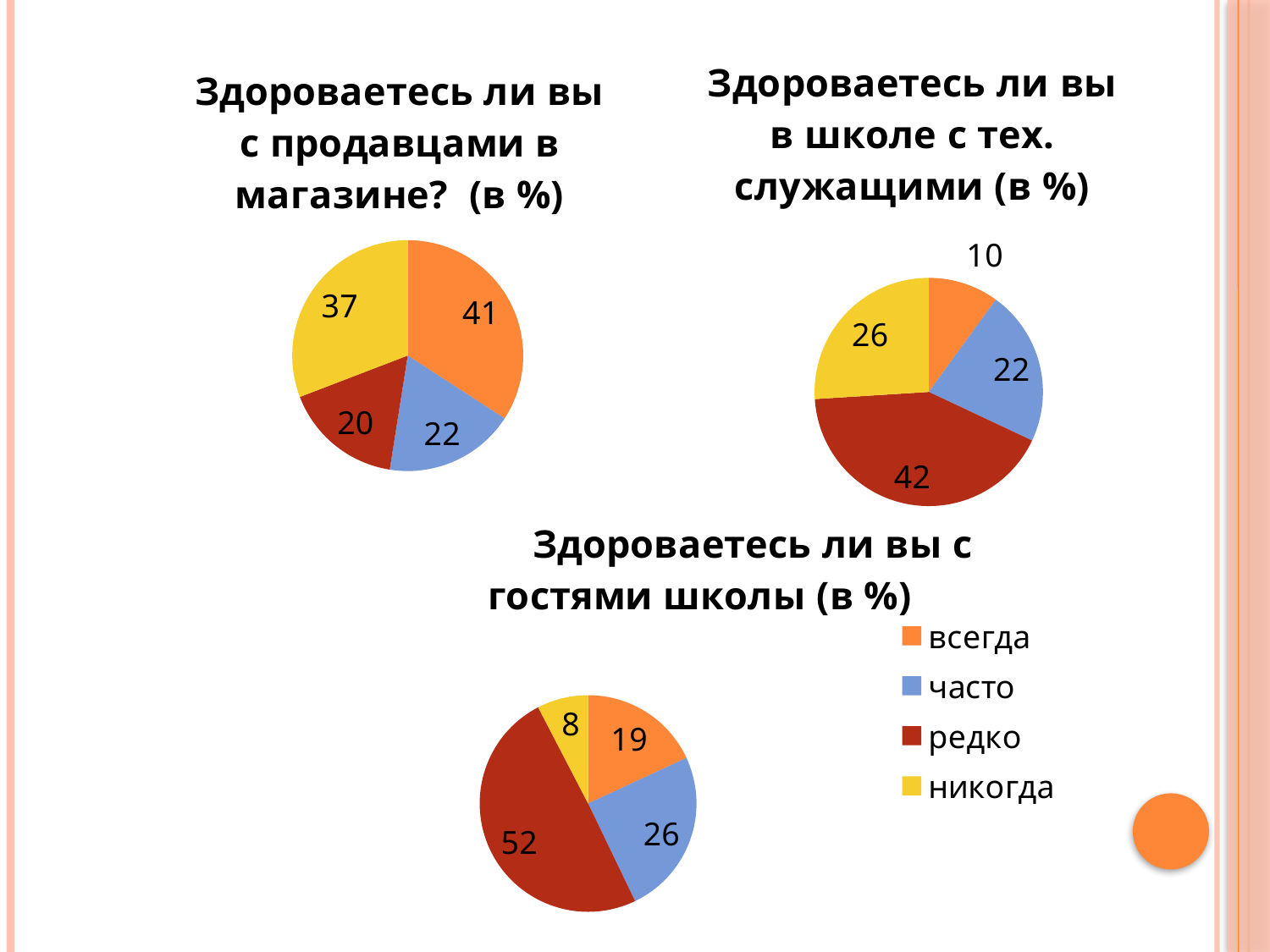
In the chart 'Здороваетесь ли вы в школе с тех. служащими (в %)', what is the value for 'всегда'? 10 In the chart 'Здороваетесь ли вы с продавцами в магазине? (в %)', which category has the lowest value? редко In the chart 'Здороваетесь ли вы в школе с тех. служащими (в %)', which is larger, the value for 'часто' or the value for 'никогда'? никогда In the chart 'Здороваетесь ли вы в школе с тех. служащими (в %)', which category has the highest value? редко In the chart 'Здороваетесь ли вы с продавцами в магазине? (в %)', what is the difference between the values for 'всегда' and 'никогда'? 4 In the chart 'Здороваетесь ли вы в школе с тех. служащими (в %)', what is the value for 'редко'? 42 What kind of chart is 'Здороваетесь ли вы с гостями школы (в %)'? pie chart In the chart 'Здороваетесь ли вы с продавцами в магазине? (в %)', what is the value for 'всегда'? 41 In the chart 'Здороваетесь ли вы с гостями школы (в %)', what is the difference between the values for 'часто' and 'всегда'? 7 In the chart 'Здороваетесь ли вы с гостями школы (в %)', which category has the lowest value? никогда In the chart 'Здороваетесь ли вы с гостями школы (в %)', what is the value for 'редко'? 52 How many categories does the legend on the slide list? 4